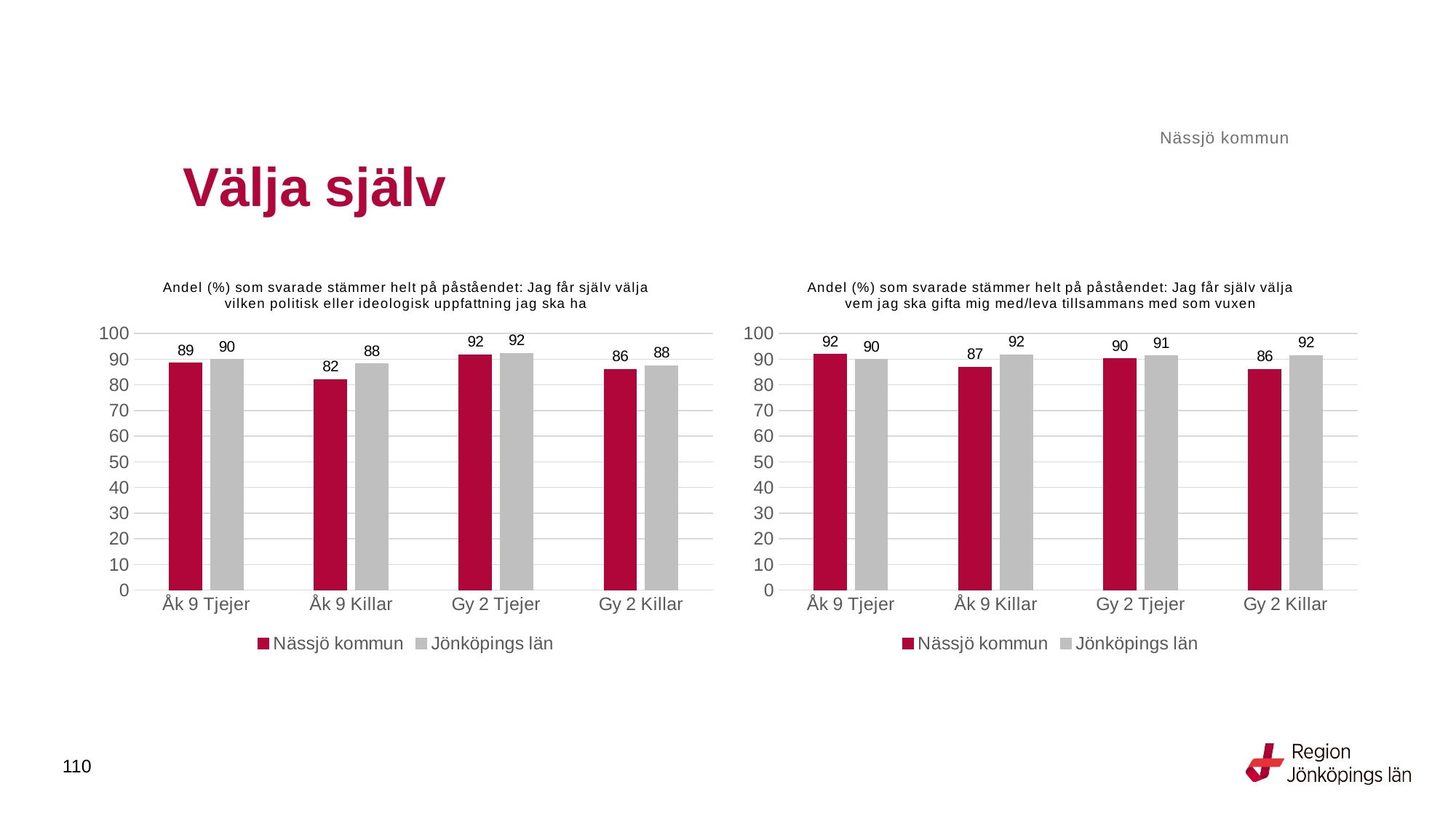
In the right chart (whom to marry/live with), what is the value for Jönköpings län for Åk 9 Killar? 92 In the right chart (whom to marry/live with), which category has the highest Nässjö kommun value? Åk 9 Tjejer How many series does the legend of the right chart list? 2 In the right chart (whom to marry/live with), which is larger for Åk 9 Tjejer: Nässjö kommun or Jönköpings län? Nässjö kommun Which colour represents Nässjö kommun in the charts? Red In the left chart (political or ideological opinion), what is the value for Nässjö kommun for Åk 9 Killar? 82 In the left chart (political or ideological opinion), what is the difference between Jönköpings län and Nässjö kommun for Åk 9 Killar? 6 How many categories are shown on the x axis of the left chart? 4 What kind of chart is the left chart? Bar chart In the left chart (political or ideological opinion), which is larger for Gy 2 Killar: Nässjö kommun or Jönköpings län? Jönköpings län In the right chart (whom to marry/live with), what is the difference between Jönköpings län and Nässjö kommun for Gy 2 Killar? 6 In the left chart (political or ideological opinion), which category has the lowest Nässjö kommun value? Åk 9 Killar